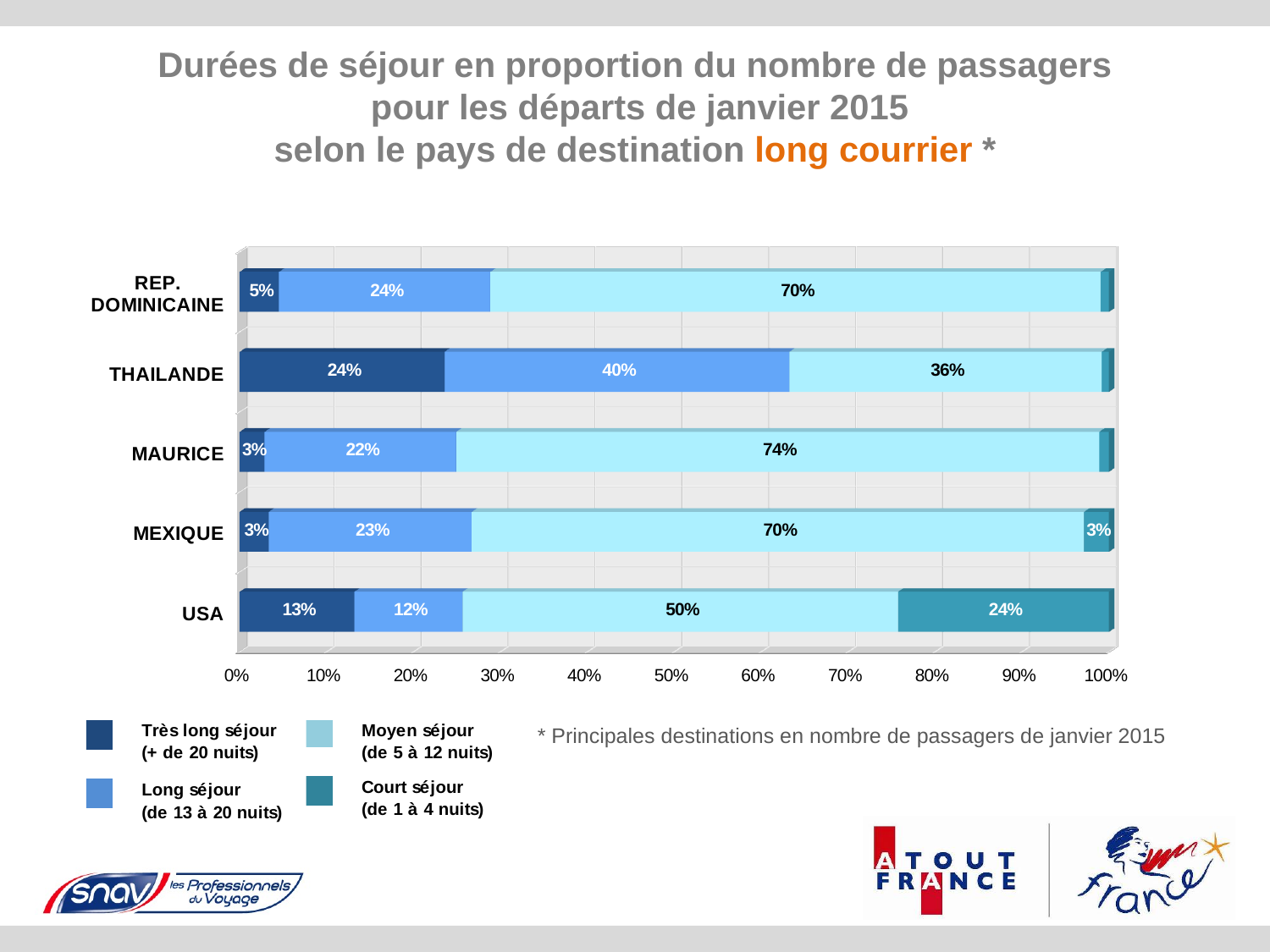
What is the Moyen séjour (de 5 à 12 nuits) share for MAURICE? 74% What is the Très long séjour (+ de 20 nuits) share for THAILANDE? 24% What kind of chart is shown on the slide? Stacked bar chart How many series does the legend list? 4 Which country has the lowest Moyen séjour (de 5 à 12 nuits) share? THAILANDE Which is larger: the Très long séjour share for USA or for MEXIQUE? USA How many destination countries are shown on the chart? 5 What is the difference between the Long séjour share for THAILANDE and for USA? 28% Which country has the highest Moyen séjour (de 5 à 12 nuits) share? MAURICE What is the Long séjour (de 13 à 20 nuits) share for REP. DOMINICAINE? 24% Which legend entry corresponds to stays of 1 to 4 nights? Court séjour (de 1 à 4 nuits) What is the Court séjour (de 1 à 4 nuits) share for USA? 24%